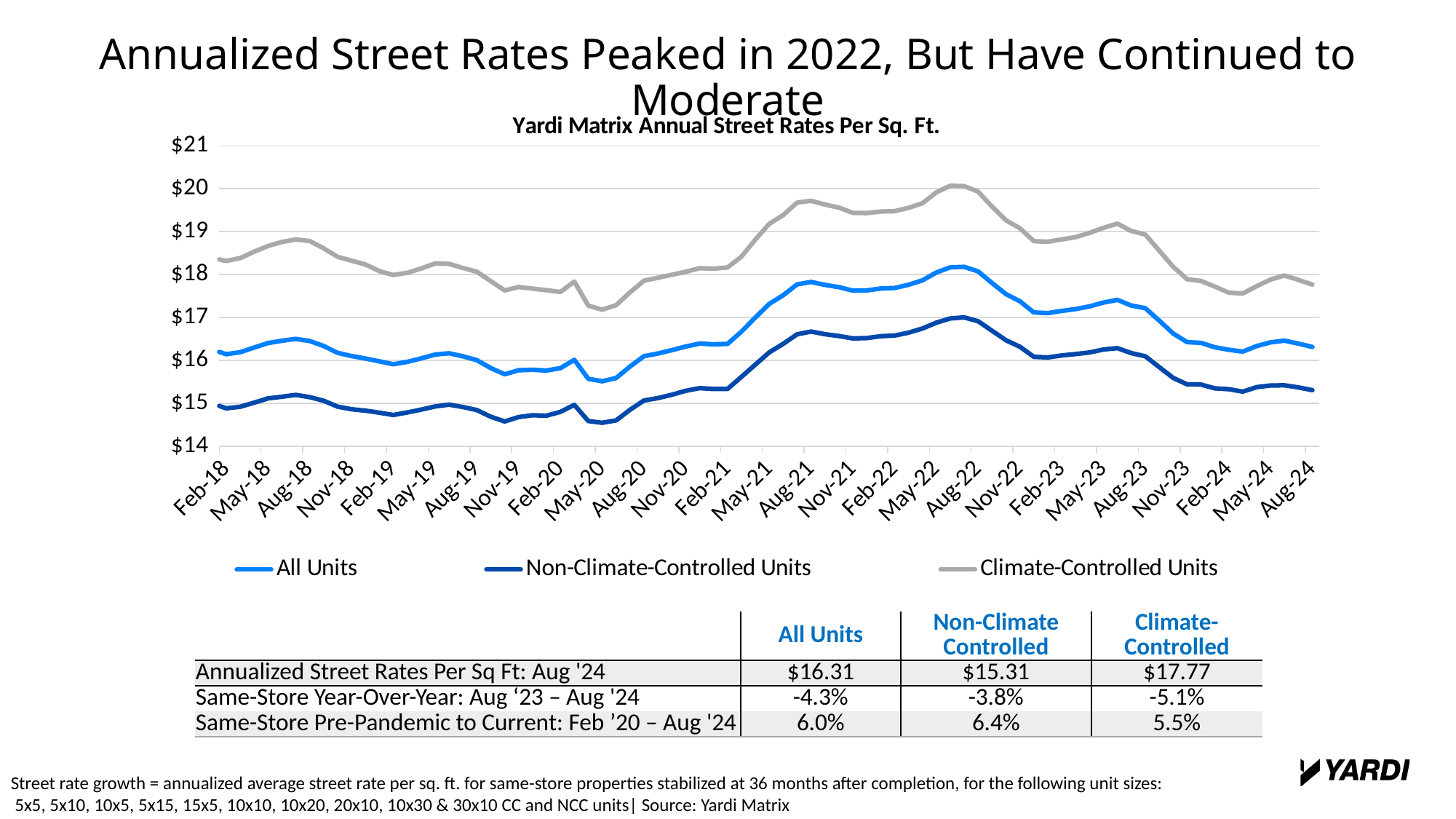
Do the All Units street rates rise or fall from Aug-22 to Aug-24? fall What is the Same-Store Year-Over-Year change for All Units from Aug '23 to Aug '24? -4.3% Is the value for All Units at Aug-21 greater or less than $17? greater Is the value for Non-Climate-Controlled Units at May-20 greater or less than $15? less What is the annualized street rate per sq ft for Non-Climate-Controlled units in Aug '24? $15.31 What is the title of the chart? Yardi Matrix Annual Street Rates Per Sq. Ft. What is the annualized street rate per sq ft for Climate-Controlled units in Aug '24? $17.77 What is the annualized street rate per sq ft for All Units in Aug '24? $16.31 How many series does the chart legend list? 3 Which series has the highest street rates across the whole chart? Climate-Controlled Units What kind of chart is shown on the slide? line chart In Aug '24, how much higher is the Climate-Controlled street rate than the Non-Climate-Controlled street rate? $2.46